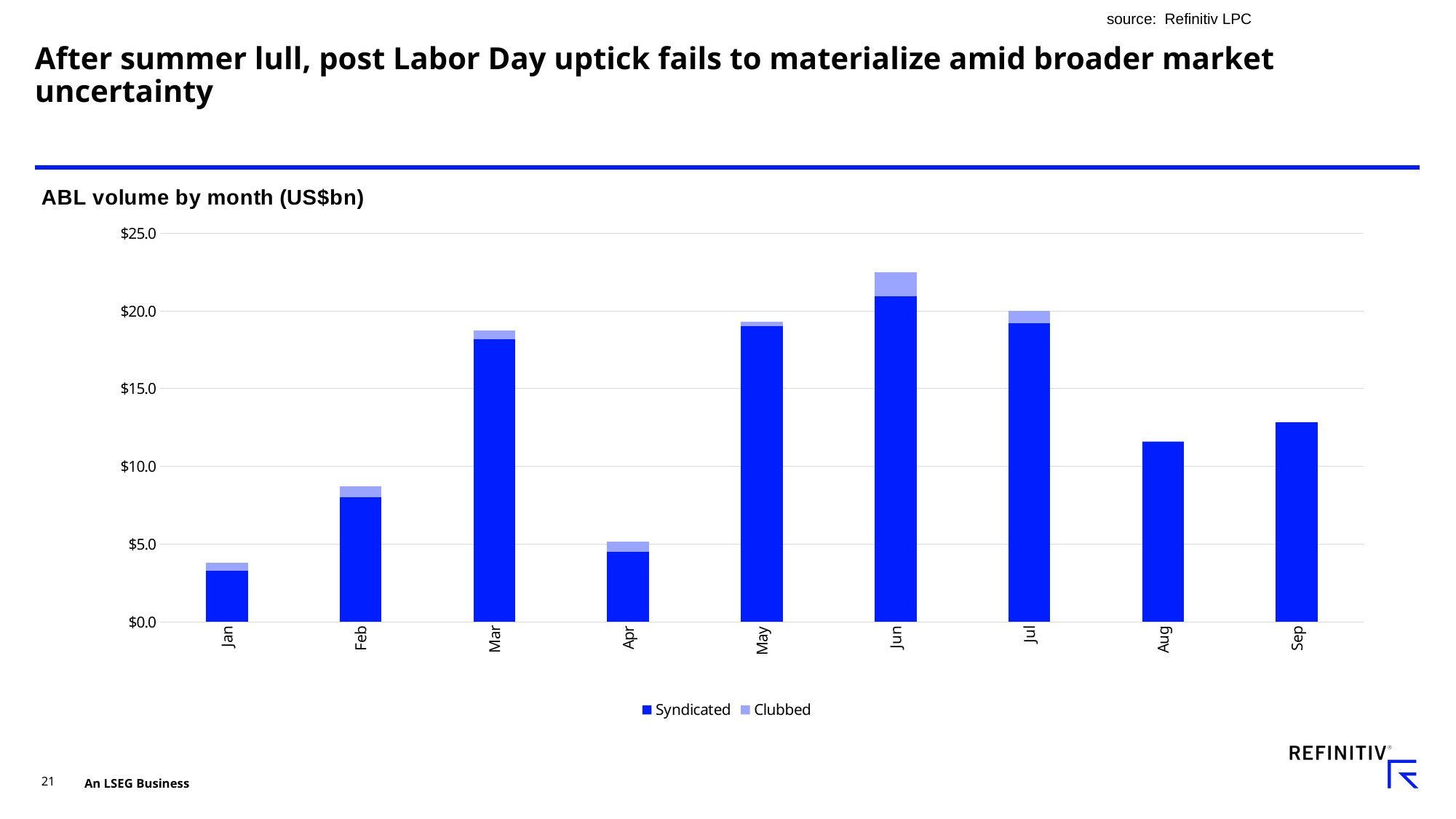
Is the total ABL volume for Jun greater or less than $20.0? greater Is the total ABL volume for Jan greater or less than $5.0? less Is the total ABL volume for Aug greater or less than $10.0? greater How many series does the legend of the ABL volume chart list? 2 Which month has the lowest total ABL volume? Jan What kind of chart is shown on the slide? Stacked bar chart Which month has the highest total ABL volume? Jun What are the two series named in the legend of the ABL volume chart? Syndicated and Clubbed Which month has the larger total ABL volume, Sep or Aug? Sep How many months are plotted on the x axis of the ABL volume chart? 9 Does the total ABL volume rise or fall from Jun to Aug? Fall